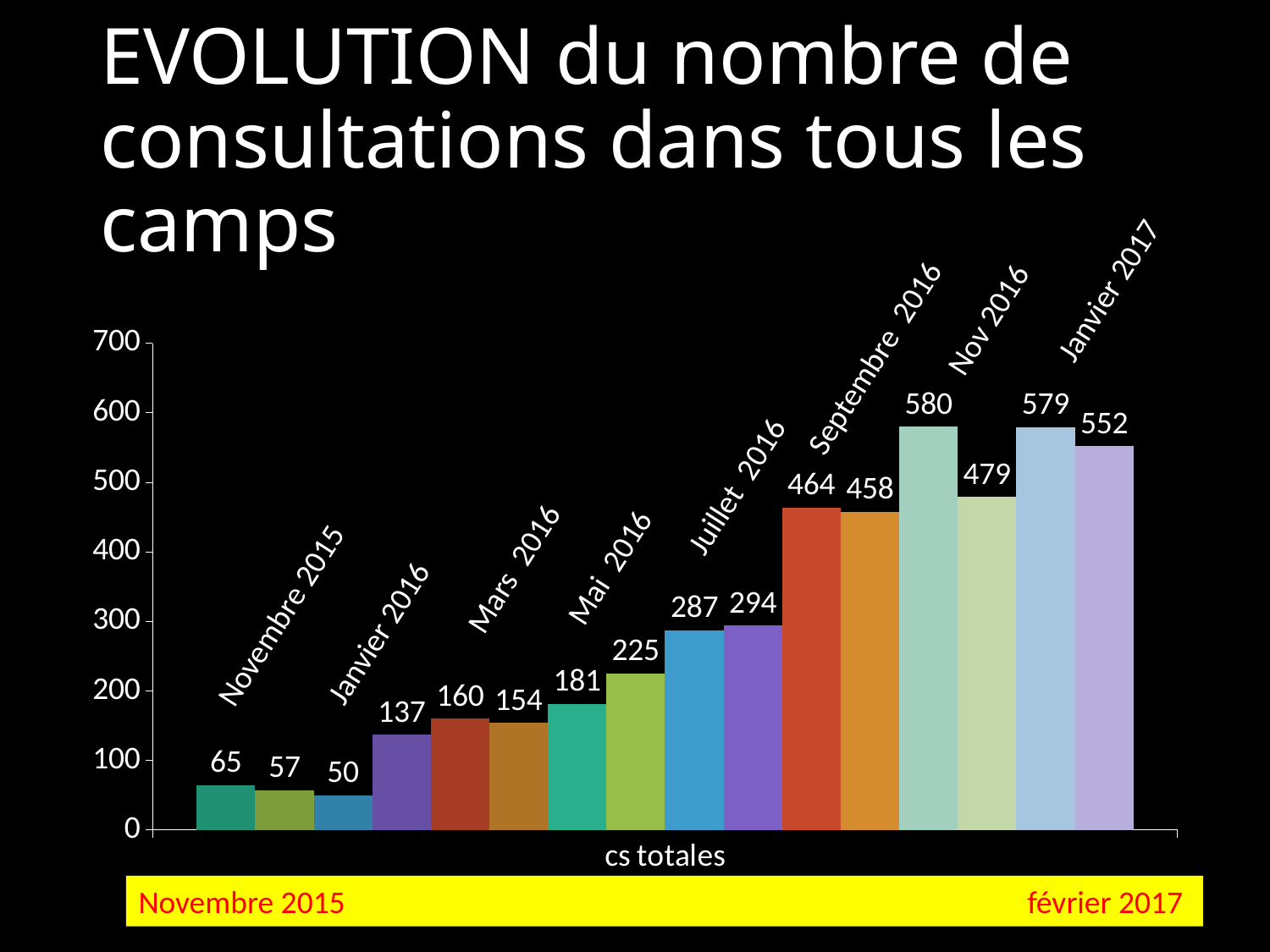
Overall, do the values rise or fall from left to right across the chart? rise What is the difference between the highest value (580) and the lowest value (50) in the chart? 530 Which is larger, the bar labelled 464 or the bar labelled 458? 464 What is the highest value shown in the chart? 580 What is the difference between the bars labelled 294 and 287? 7 What is the value of the first (leftmost) bar in the chart? 65 What is the maximum value shown on the vertical axis of the chart? 700 What is the lowest value shown in the chart? 50 What type of chart is shown on the slide? bar chart What is the value of the last (rightmost) bar in the chart? 552 How many bars are plotted in the chart? 16 What is the label shown beneath the x axis of the chart? cs totales